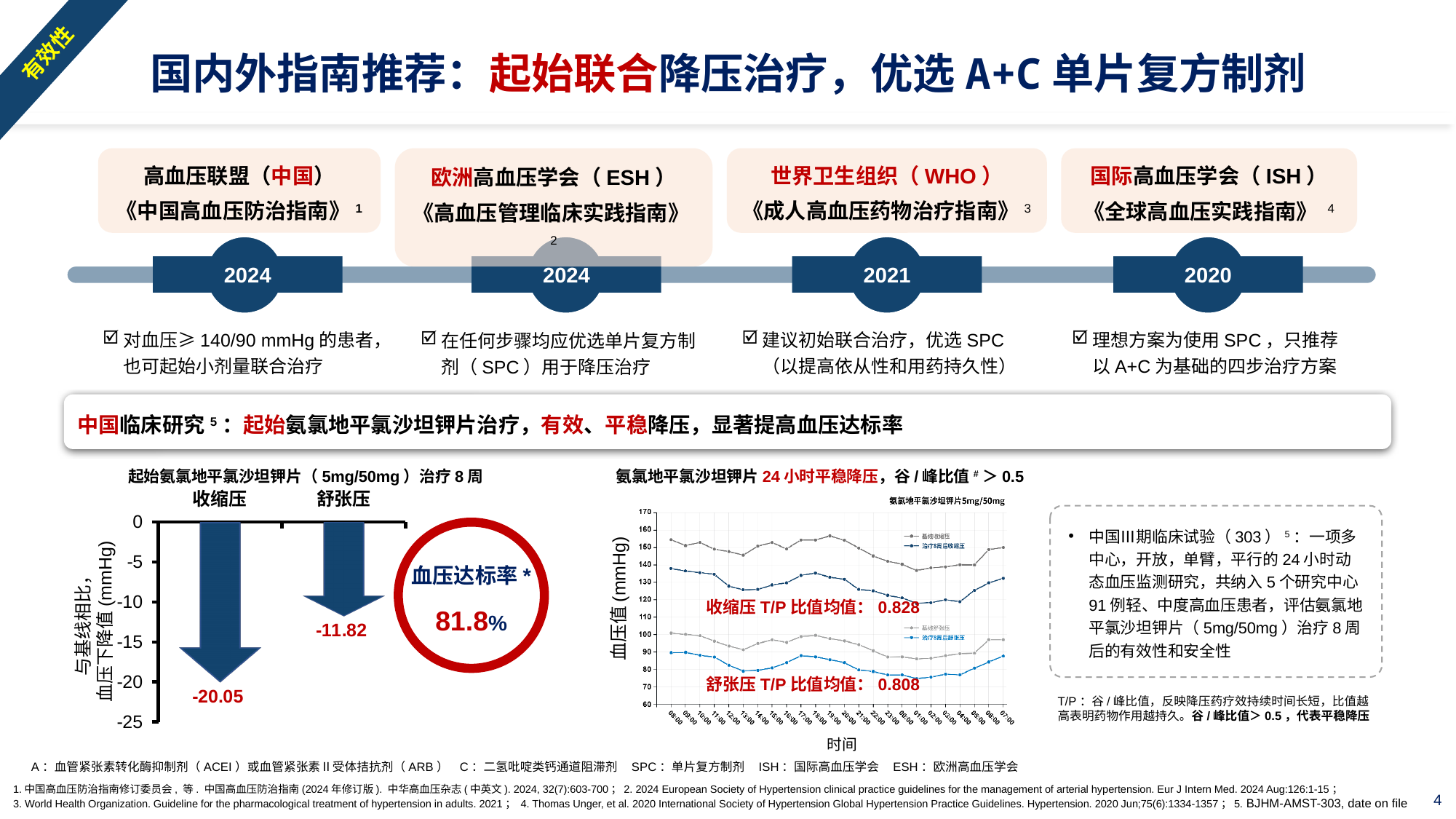
On the right chart (24小时平稳降压), is the 治疗8周后舒张压 value at 13:00 greater or less than 90? less What kind of chart is the left chart showing blood pressure reduction from baseline? Bar chart What kind of chart is the right chart (氨氯地平氯沙坦钾片 24小时平稳降压)? Line chart On the left chart, what is the difference between the 收缩压 reduction and the 舒张压 reduction? 8.23 On the right chart (24小时平稳降压), what is the mean 收缩压 T/P ratio shown? 0.828 On the left chart (起始氨氯地平氯沙坦钾片治疗8周), what is the reduction from baseline for 收缩压? -20.05 On the right chart (24小时平稳降压), is the 基线收缩压 value at 08:00 greater or less than 140? greater On the right chart (24小时平稳降压), how many series does the legend list? 4 On the left chart, what is the y-axis label? 与基线相比，血压下降值 (mmHg) On the left chart (起始氨氯地平氯沙坦钾片治疗8周), what is the reduction from baseline for 舒张压? -11.82 On the left chart, how many categories are plotted? 2 On the left chart, which category shows the larger reduction from baseline, 收缩压 or 舒张压? 收缩压